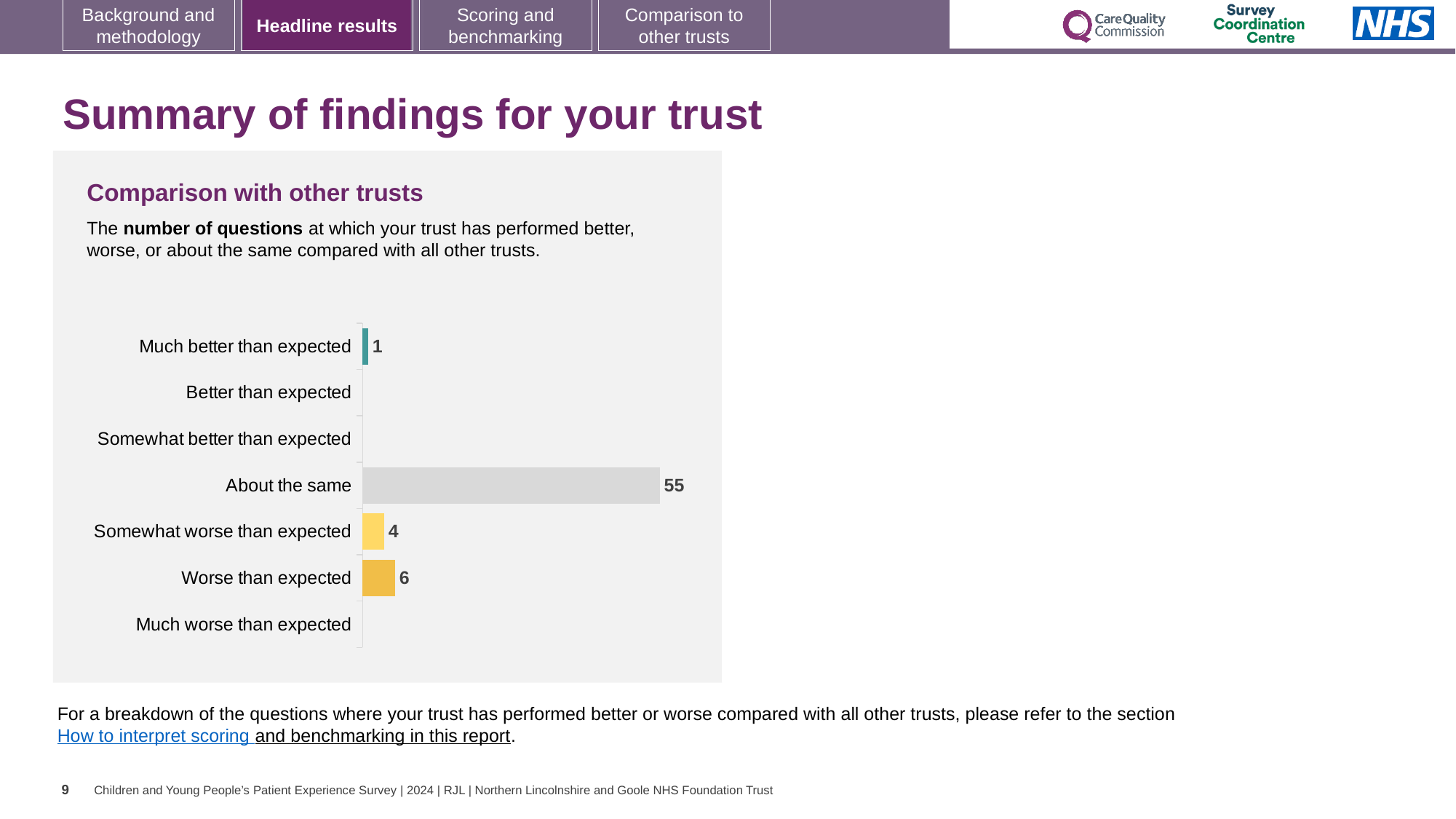
What is the value for 'Worse than expected'? 6 What is the value for 'Much better than expected'? 1 Which is larger, the value for 'Worse than expected' or the value for 'Much better than expected'? Worse than expected What is the difference between the values for 'About the same' and 'Worse than expected'? 49 What colour is the bar for 'About the same'? Grey What is the difference between the values for 'Worse than expected' and 'Somewhat worse than expected'? 2 What is the value for 'About the same'? 55 What is the value for 'Somewhat worse than expected'? 4 What kind of chart is shown on the slide? Bar chart How many categories are listed on the chart? 7 Which category has the highest value? About the same What is the title of the chart? Comparison with other trusts